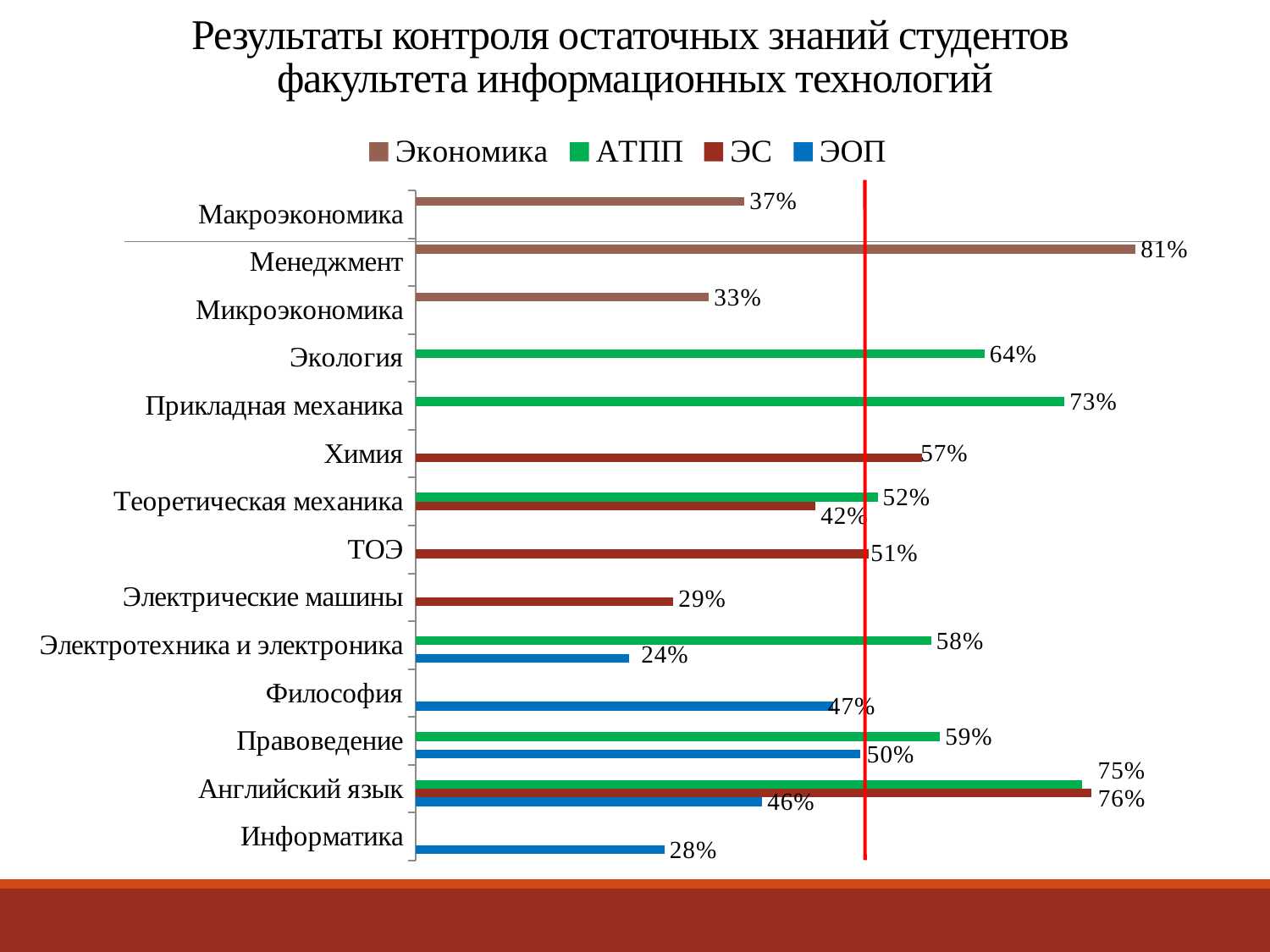
How many categories are shown on the vertical axis? 14 Which series is shown in green in the legend? АТПП Which category has the lowest value in the ЭОП series? Электротехника и электроника What is the ЭС value for Английский язык? 76% What is the value for Прикладная механика in the АТПП series? 73% How many series does the legend list? 4 What is the difference between the АТПП and ЭС values for Теоретическая механика? 10% What is the value for Менеджмент in the Экономика series? 81% Which category has the highest value in the Экономика series? Менеджмент For Правоведение, which series has the larger value, АТПП or ЭОП? АТПП What is the ЭОП value for Информатика? 28% What kind of chart is shown on the slide? bar chart